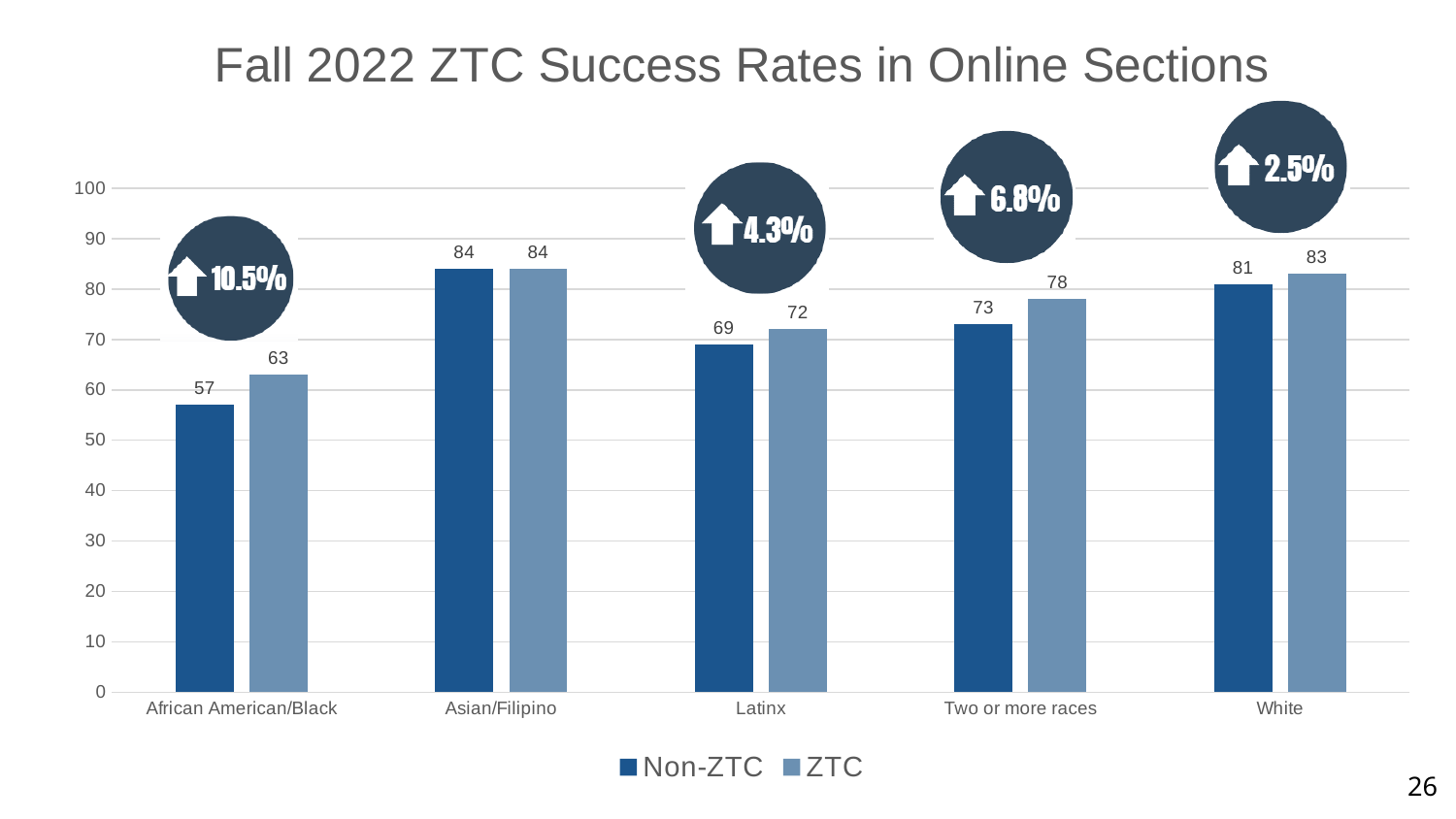
What is the ZTC value for White? 83 Which category has the highest ZTC value? Asian/Filipino How many series does the legend list? 2 How many categories are shown on the x axis? 5 What is the Non-ZTC success rate for African American/Black students? 57 Which is larger for Two or more races, the Non-ZTC value or the ZTC value? ZTC What is the difference between the ZTC and Non-ZTC values for Latinx? 3 What is the title of the chart? Fall 2022 ZTC Success Rates in Online Sections Which category has the lowest Non-ZTC value? African American/Black What is the difference between the ZTC and Non-ZTC values for African American/Black? 6 What is the ZTC success rate for Two or more races? 78 What kind of chart is shown on the slide? Bar chart